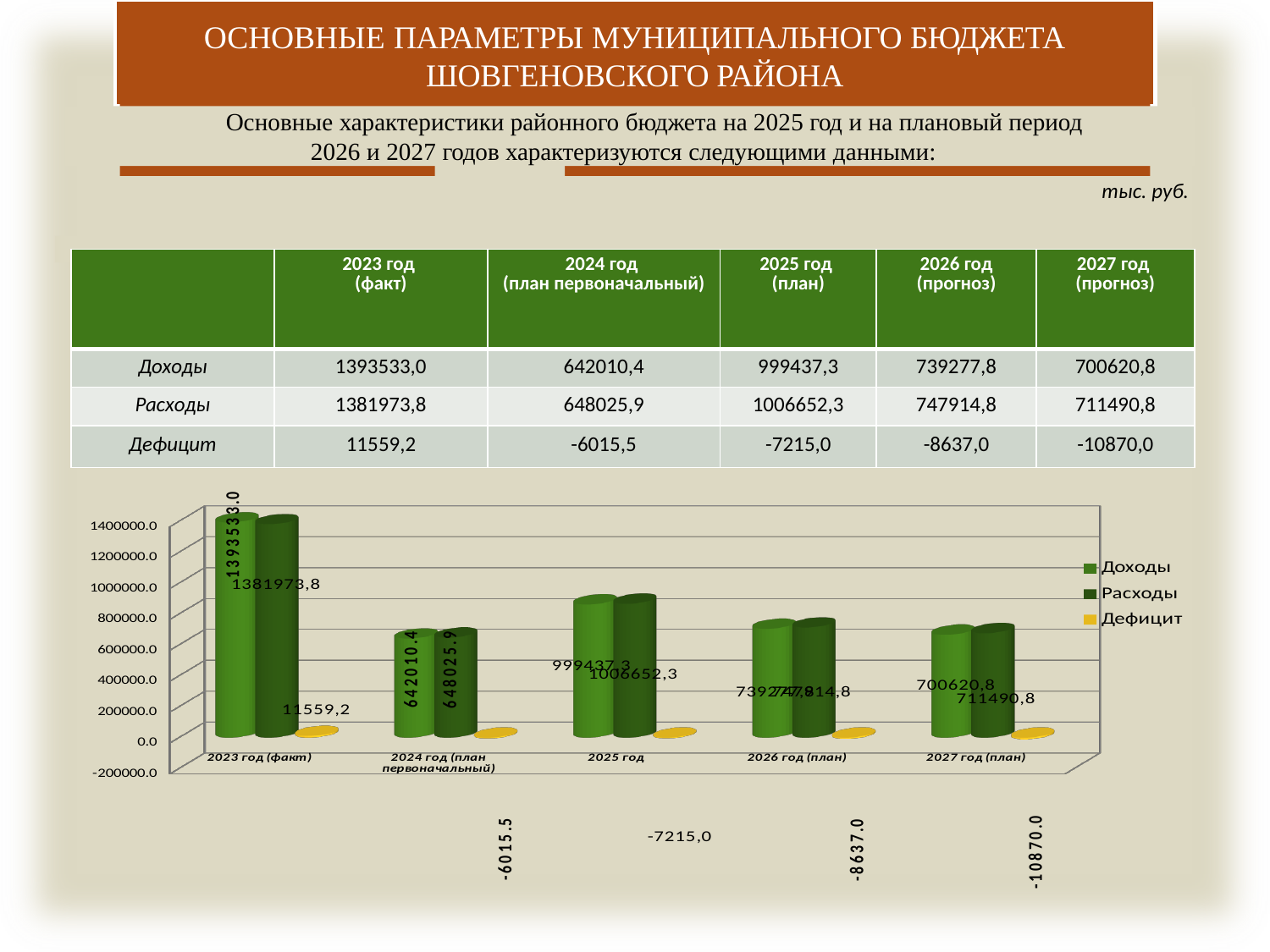
What is the value of Доходы for 2023 год (факт) in the chart? 1393533.0 Is the Расходы value for 2024 год (план первоначальный) greater or less than 800000.0? less Which is larger in the chart: Доходы for 2025 год or Доходы for 2026 год (план)? Доходы for 2025 год Which series in the chart legend is shown in yellow? Дефицит Which year category has the highest Доходы value in the chart? 2023 год (факт) How many year categories are plotted along the x axis of the chart? 5 What kind of chart is shown on the slide? bar chart How many series does the chart legend list? 3 What is the value of Расходы for 2025 год in the chart? 1006652,3 What is the value of Дефицит for 2027 год (план) in the chart? -10870.0 Which year category has the lowest Доходы value in the chart? 2024 год (план первоначальный) What is the value of Расходы for 2023 год (факт) in the chart? 1381973,8